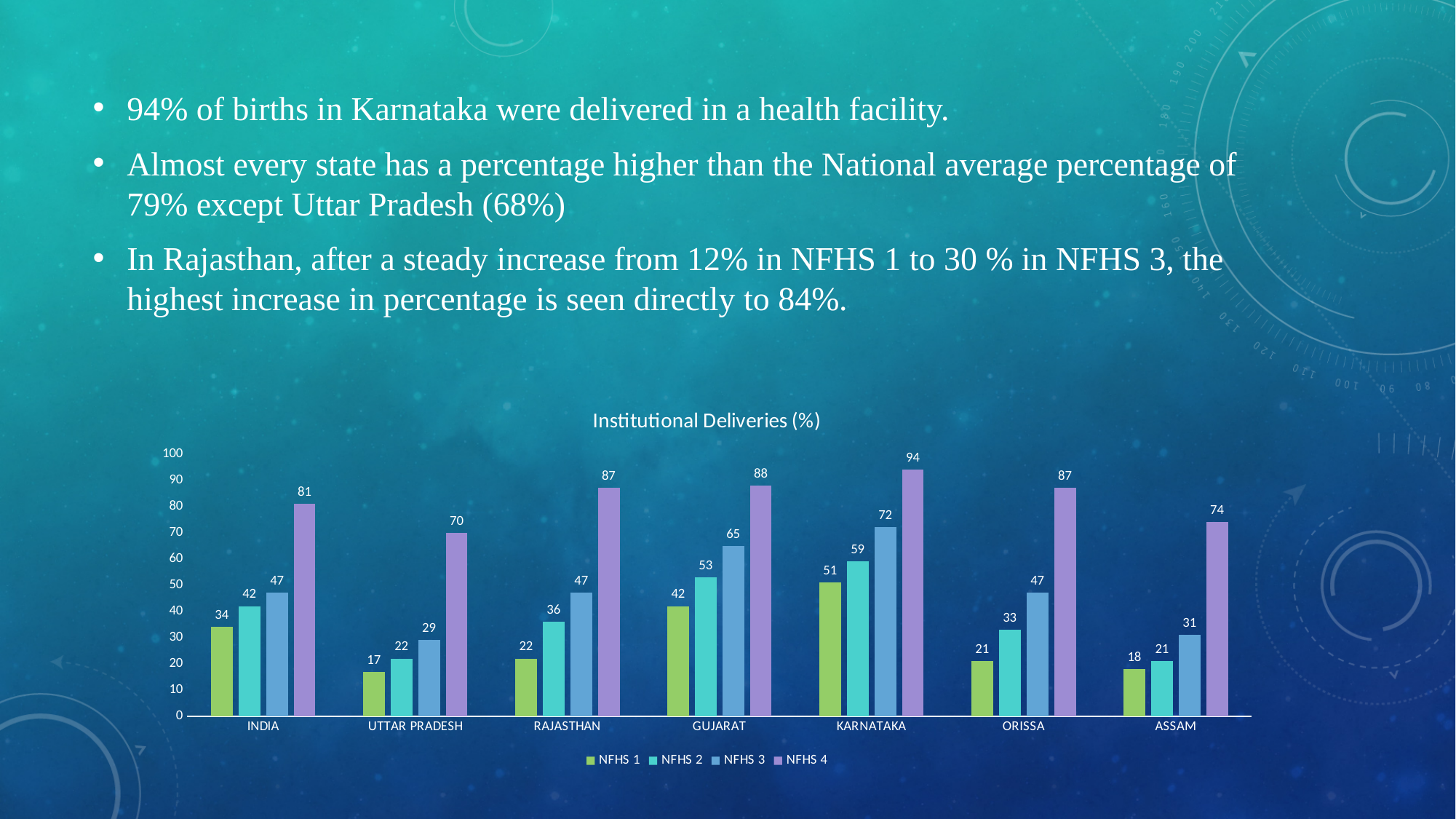
How many categories are shown on the x axis? 7 What is the difference between the NFHS 4 and NFHS 3 values for Rajasthan? 40 Which category has the lowest NFHS 1 value? Uttar Pradesh What is the NFHS 1 value for Uttar Pradesh? 17 What is the NFHS 4 value for Karnataka? 94 Which is larger, the NFHS 2 value for Orissa or the NFHS 2 value for Assam? Orissa Do the values for India rise or fall from NFHS 1 to NFHS 4? Rise Which state has the highest NFHS 4 value? Karnataka What kind of chart is shown on the slide? Bar chart How many series does the legend list? 4 What is the NFHS 3 value for Gujarat? 65 What is the title of the chart? Institutional Deliveries (%)